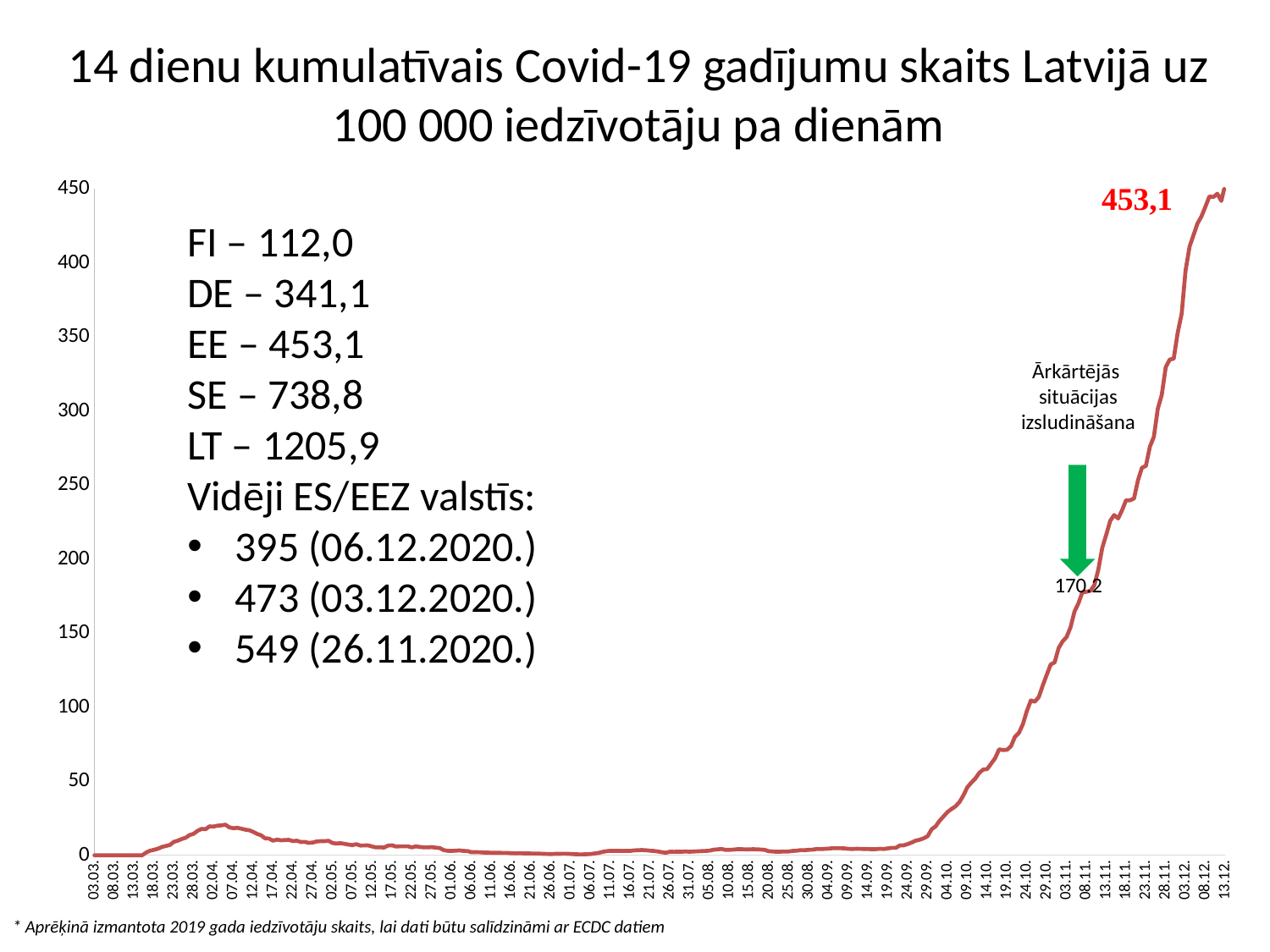
What is the latest value labelled at the end of the line (13.12.)? 453,1 What event does the green arrow annotation on the chart mark? Ārkārtējās situācijas izsludināšana What is the title of the chart? 14 dienu kumulatīvais Covid-19 gadījumu skaits Latvijā uz 100 000 iedzīvotāju pa dienām What value is labelled at the point marked by the green arrow (Ārkārtējās situācijas izsludināšana)? 170.2 Does the line rise or fall between 24.09. and 13.12.? rises What is the highest value labelled on the chart? 453,1 Is the value on 01.07. greater or less than 50? less Which of the two labelled values is larger: the one at the emergency declaration or the one at the end of the line? the one at the end of the line (453,1) Is the spring peak around 07.04. greater or less than 50? less Is the value on 13.12. greater or less than 400? greater What is the difference between the final labelled value (453,1) and the value at the emergency declaration (170,2)? 282,9 What kind of chart is shown on the slide? line chart